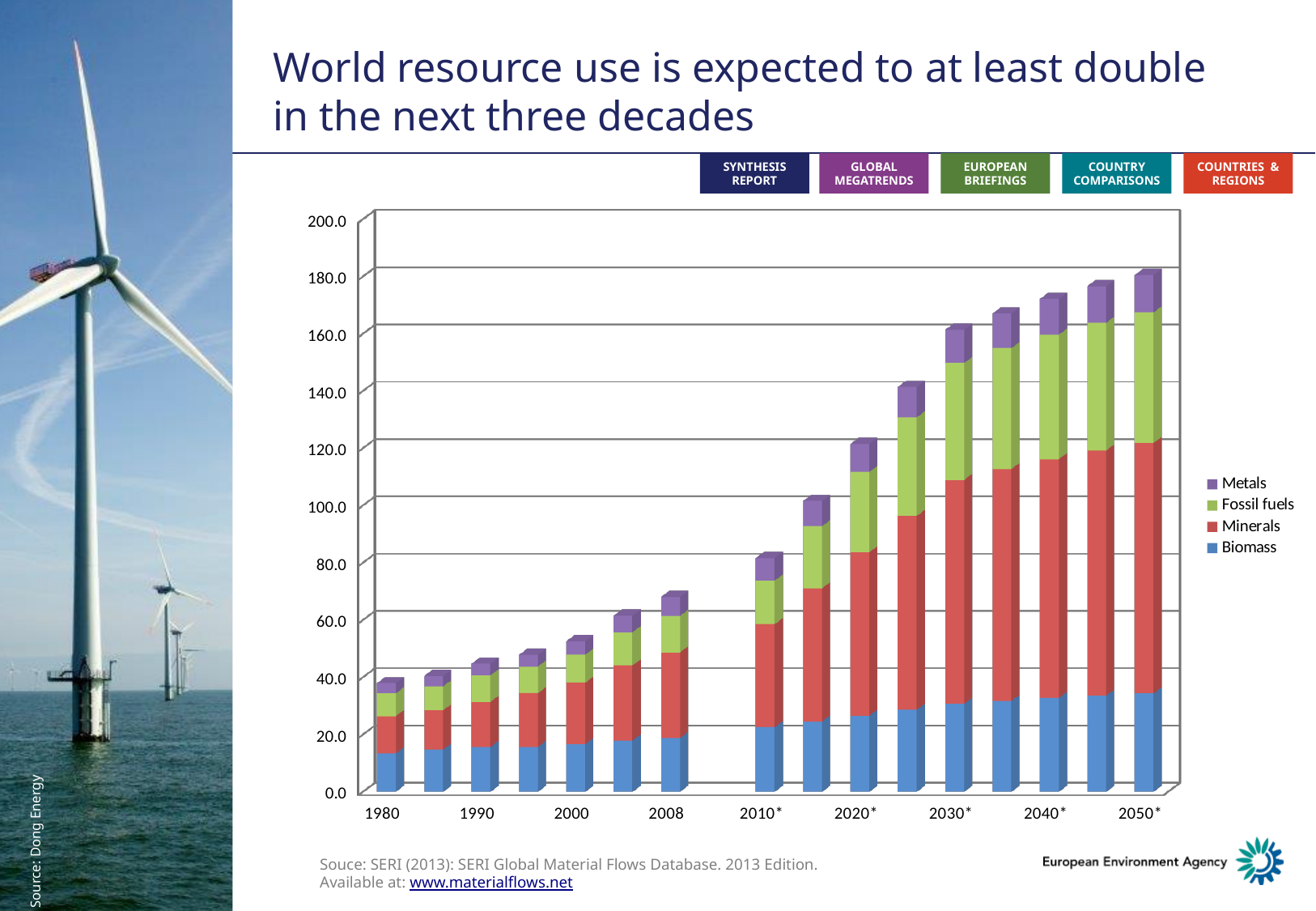
Is the total of the stacked bar for 1980 greater or less than 60.0? less What kind of chart is shown on the slide? Stacked bar chart Which stacked bar is taller, 2020* or 2000? 2020* How many series does the chart legend list? 4 Is the total of the stacked bar for 2030* greater or less than 140.0? greater Is the total of the stacked bar for 2008 greater or less than 80.0? less What colour represents Minerals in the chart legend? Red Which year has the shortest stacked bar? 1980 Which year has the tallest stacked bar? 2050* Which series is shown at the bottom of each stacked bar? Biomass Do the stacked bar totals rise or fall from 1980 to 2050*? Rise